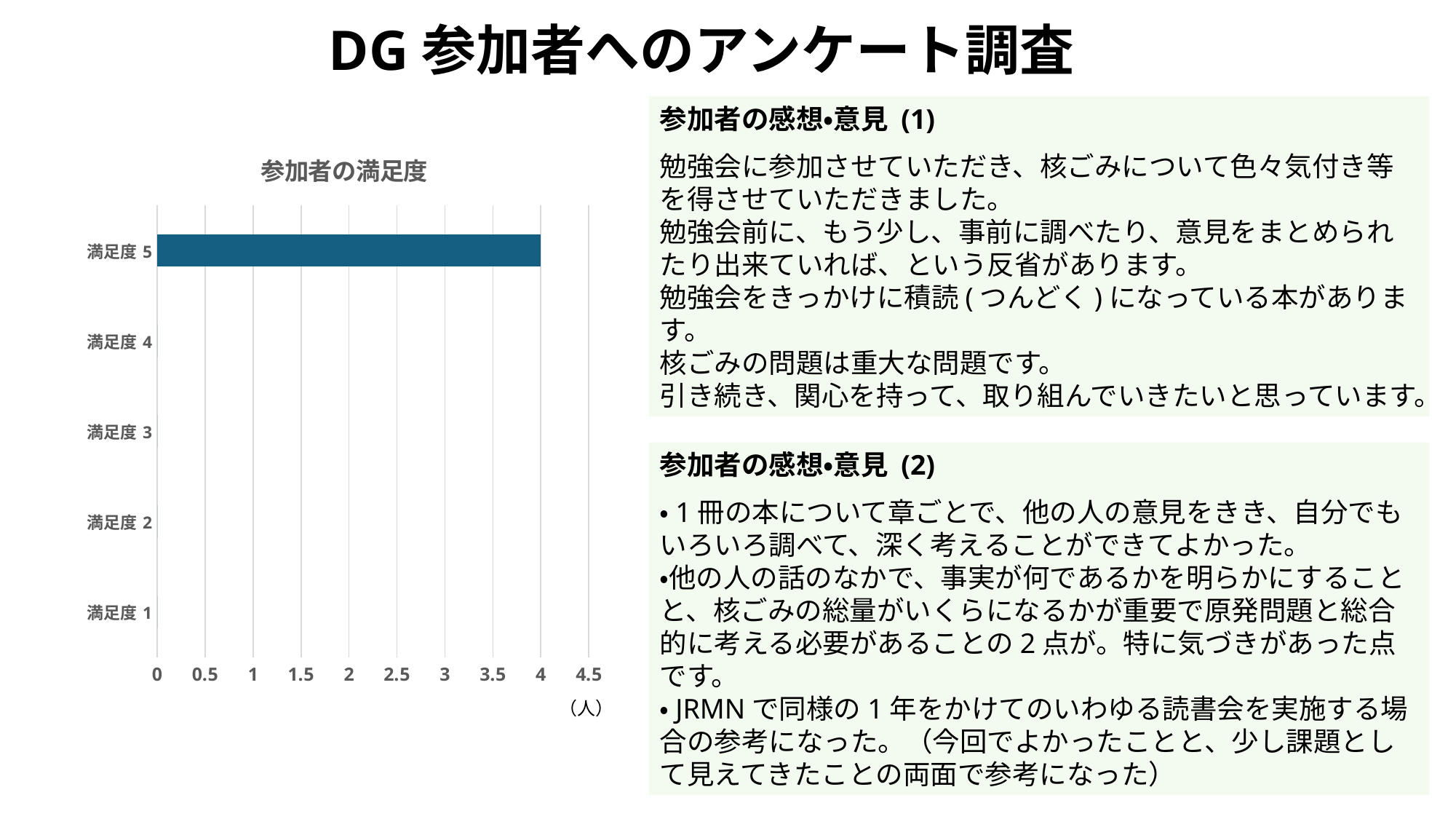
What is the value for 満足度 5? 4 Is the value for 満足度 5 greater or less than 4.5? less What is the value for 満足度 3? 0 How many categories are shown on the chart's vertical axis? 5 What unit is shown below the horizontal axis of the chart? （人） Is the value for 満足度 5 greater or less than 3? greater What is the title of the chart? 参加者の満足度 What kind of chart is shown on the slide? bar chart What is the highest tick value shown on the horizontal axis? 4.5 Which is larger, the value for 満足度 5 or the value for 満足度 4? 満足度 5 What is the difference between the value for 満足度 5 and the value for 満足度 1? 4 Which category has the highest value? 満足度 5